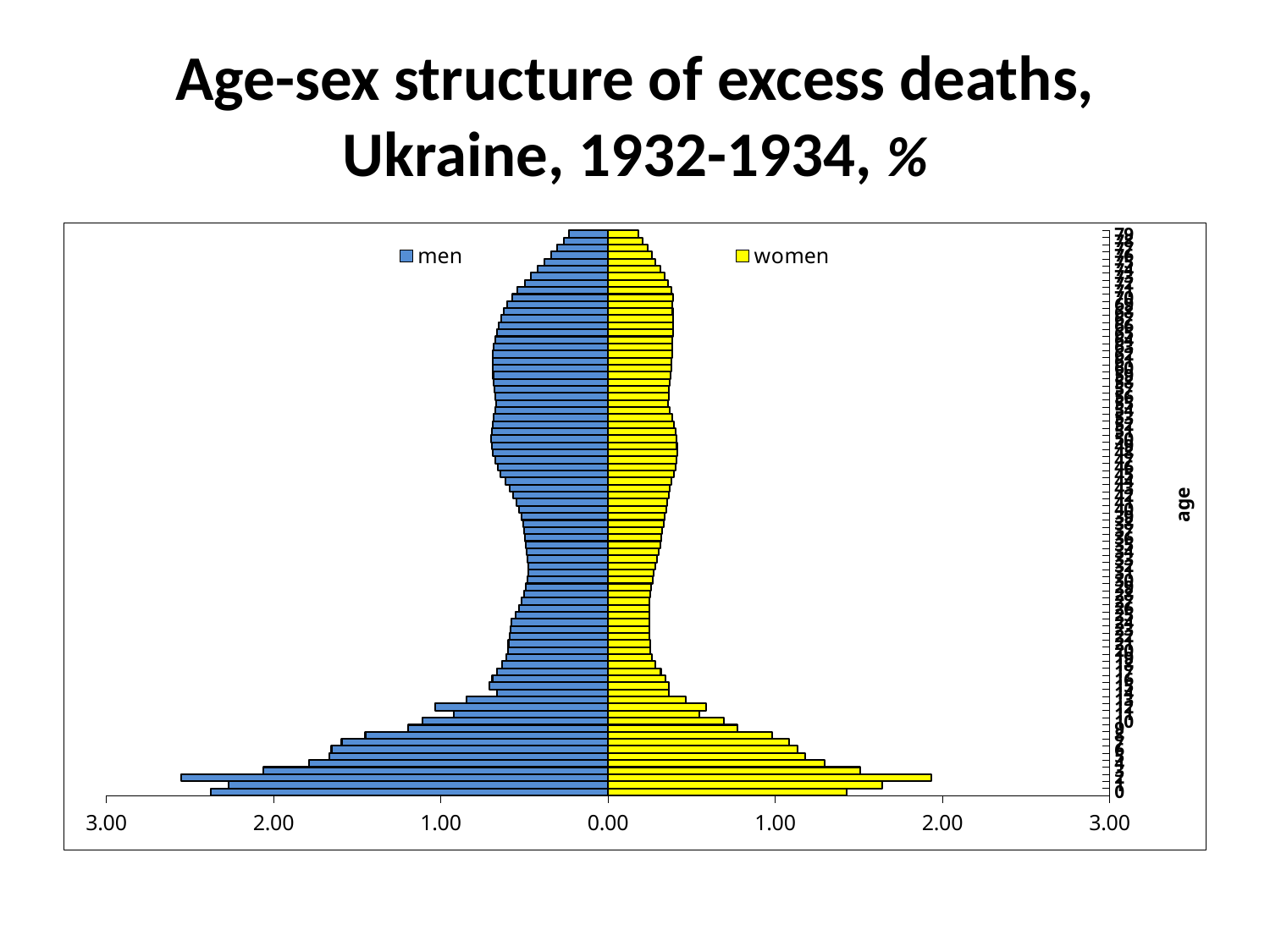
Is the longest bar for men greater or less than 3.00? less Which series has the single longest bar in the chart, men or women? men What are the two series named in the legend? men and women How many series does the legend list? 2 Is the longest bar for women greater or less than 3.00? less Is the longest bar for men greater or less than 2.00? greater What kind of chart is shown on the slide? bar chart Which colour represents women in the chart? yellow Are the longest bars located at the bottom or the top of the chart? bottom